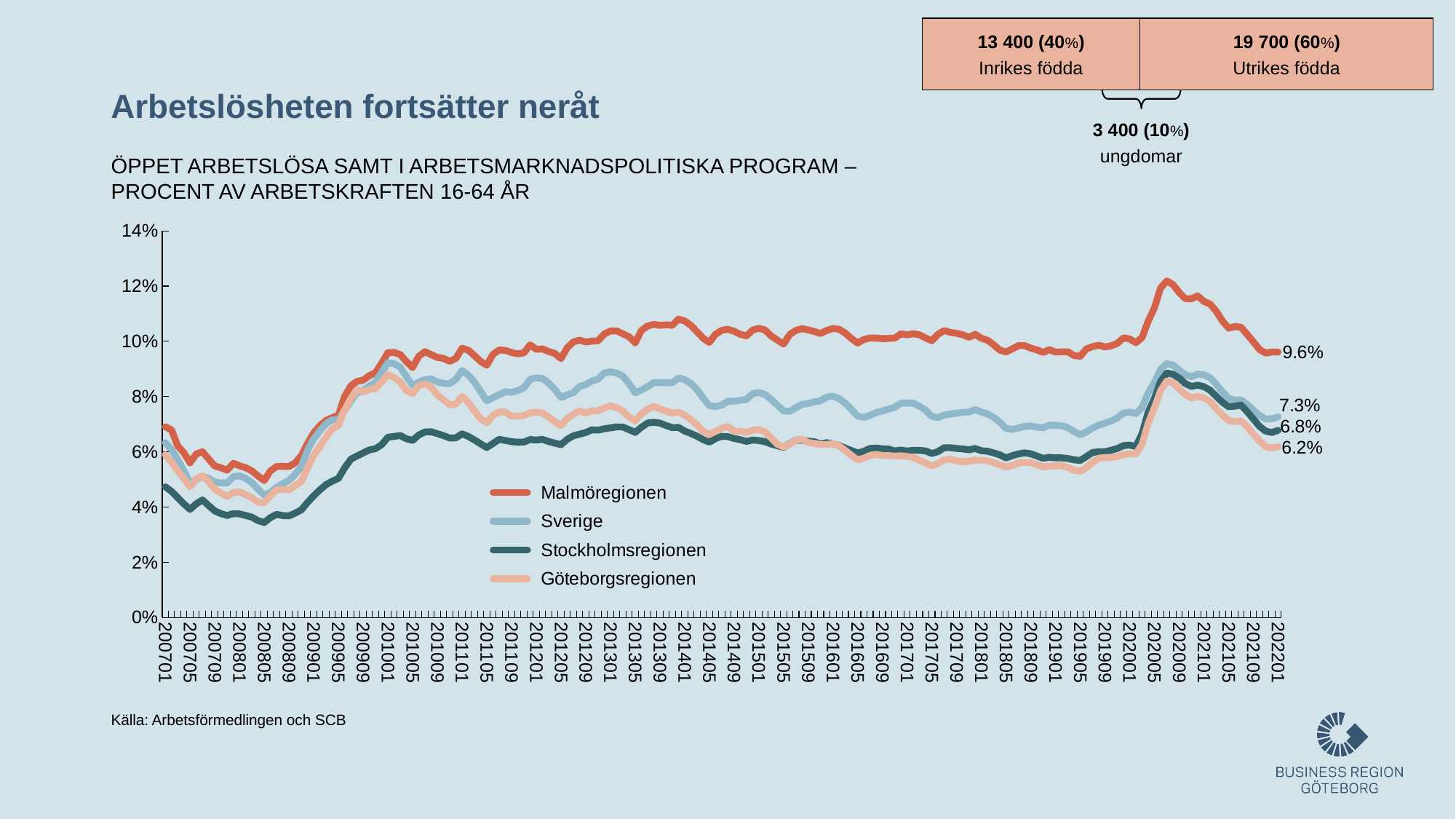
What is the value labelled at the end of the Göteborgsregionen line? 6.2% What is the value labelled at the end of the Malmöregionen line? 9.6% At the end of the chart, which is larger: the Sverige value or the Stockholmsregionen value? Sverige How many series does the legend list? 4 Does the Malmöregionen line rise or fall between 202005 and 202201? fall What is the difference between the end values of Malmöregionen (9.6%) and Göteborgsregionen (6.2%)? 3.4 percentage points Which series has the highest value at the end of the chart (202201)? Malmöregionen What is the value labelled at the end of the Stockholmsregionen line? 6.8% What is the value labelled at the end of the Sverige line? 7.3% Which series has the lowest value at the end of the chart (202201)? Göteborgsregionen Is the value for Stockholmsregionen around 200805 greater or less than 4%? less What kind of chart is shown on the slide? line chart